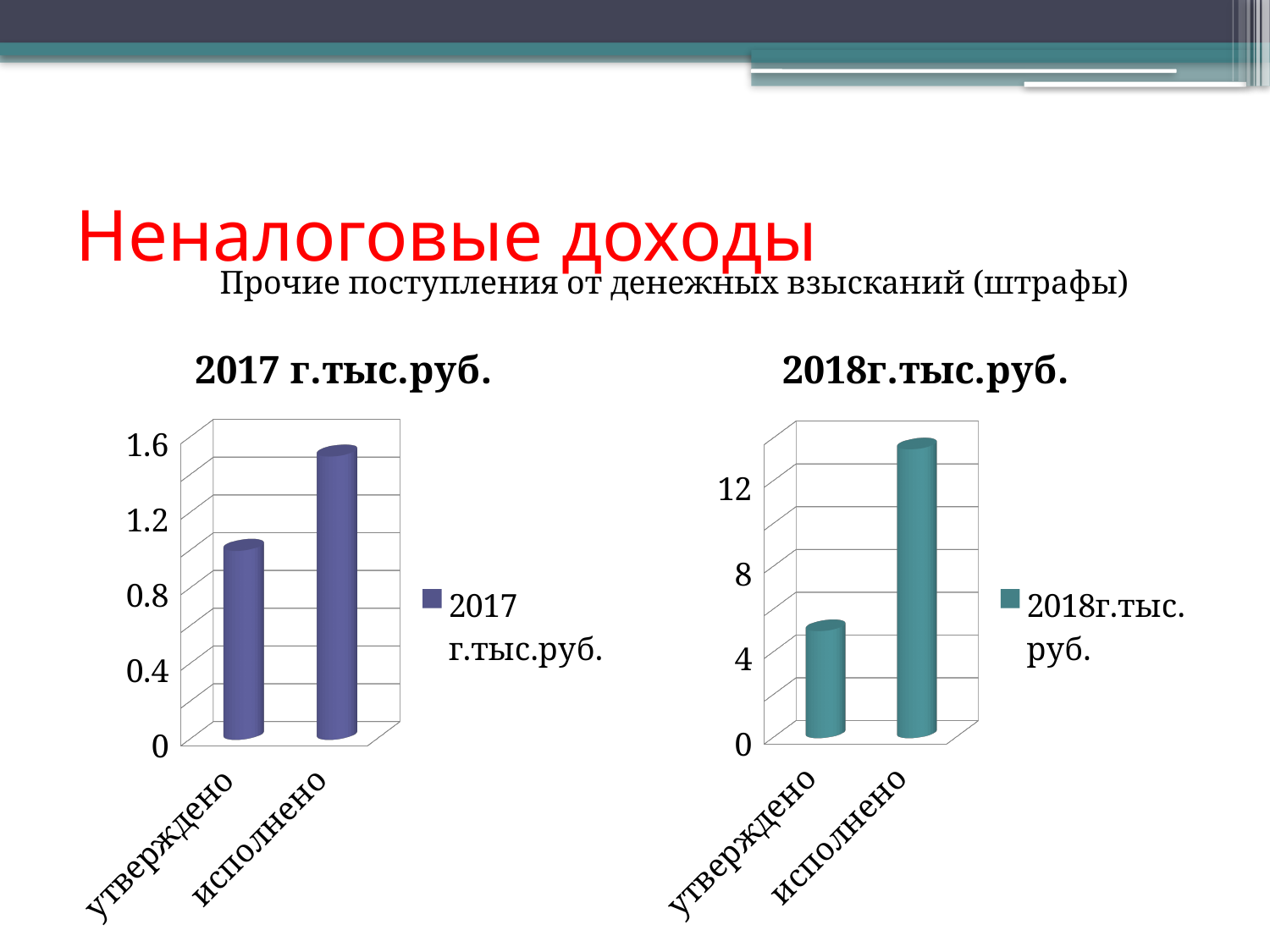
In the "2017 г.тыс.руб." chart, which category has the highest value? исполнено In the "2018г.тыс.руб." chart, which is larger, утверждено or исполнено? исполнено In the "2017 г.тыс.руб." chart, is the value for утверждено greater or less than 0.8? greater In the "2018г.тыс.руб." chart, is the value for исполнено greater or less than 12? greater What is the legend entry of the "2017 г.тыс.руб." chart? 2017 г.тыс.руб. In the "2018г.тыс.руб." chart, which category has the lowest value? утверждено How many categories are shown in the "2017 г.тыс.руб." chart? 2 In the "2017 г.тыс.руб." chart, is the value for исполнено greater or less than 1.2? greater How many series does the legend of the "2018г.тыс.руб." chart list? 1 What kind of chart is the "2018г.тыс.руб." chart? bar chart What kind of chart is the "2017 г.тыс.руб." chart? bar chart